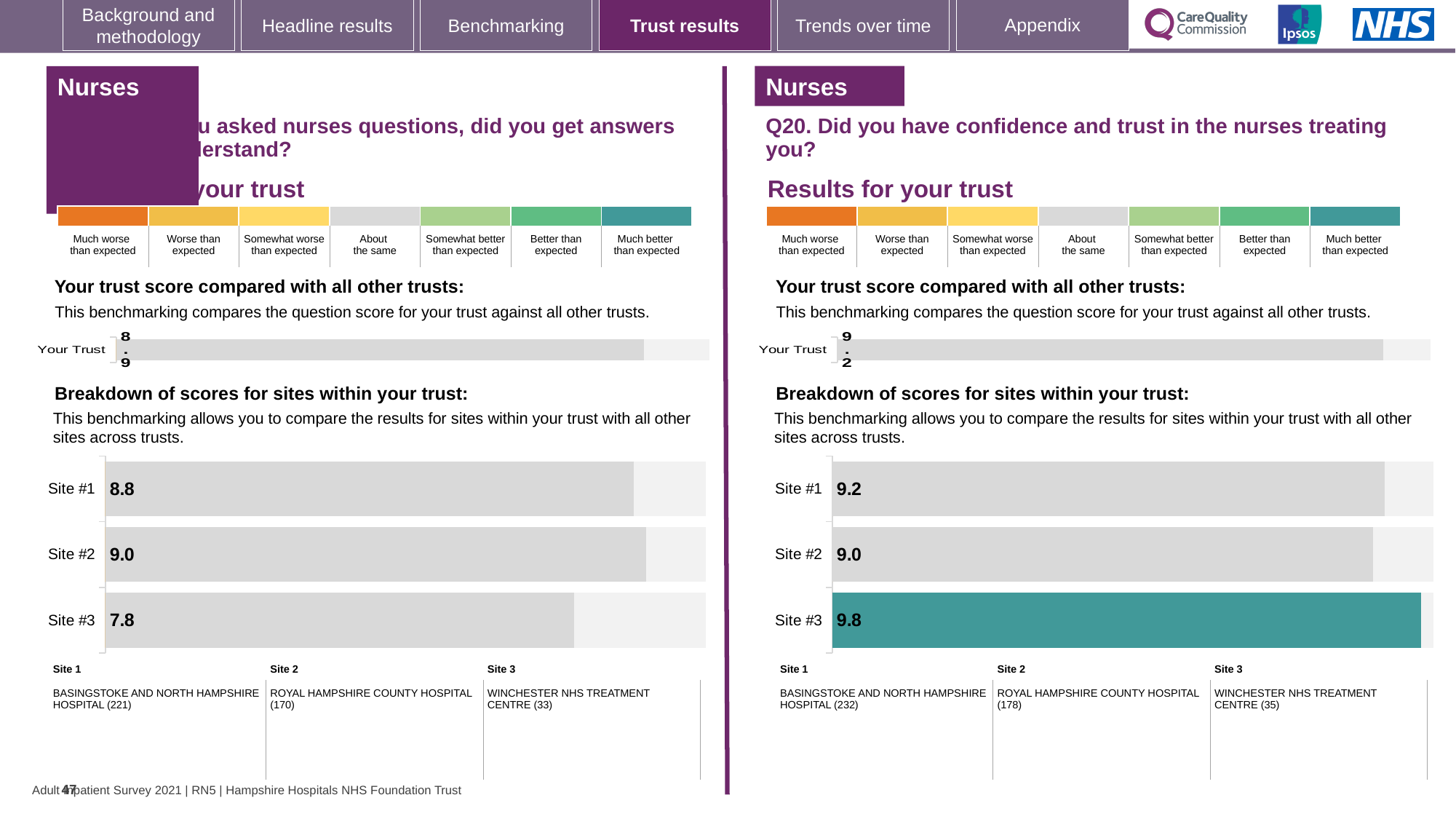
What type of chart is used for the breakdown of scores for sites within your trust in the Q20 panel? Bar chart In the Q20 panel's breakdown of scores for sites within your trust, what is the difference between the scores for Site #3 and Site #1? 0.6 How many sites are shown in the Q20 panel's breakdown of scores for sites within your trust? 3 In the left panel's breakdown of scores for sites within your trust, what is the score for Site #3? 7.8 In the left panel's 'Your trust score compared with all other trusts' chart, what is the score for Your Trust? 8.9 In the Q20 panel's breakdown of scores for sites within your trust, which site has the lowest score? Site #2 In the left panel's breakdown of scores for sites within your trust, which site has the lowest score? Site #3 In the Q20 panel's 'Your trust score compared with all other trusts' chart, what is the score for Your Trust? 9.2 In the left panel's breakdown of scores for sites within your trust, what is the difference between the scores for Site #2 and Site #3? 1.2 In the left panel's breakdown of scores for sites within your trust, which site has the highest score? Site #2 In the Q20 panel's breakdown of scores for sites within your trust, which site has the highest score? Site #3 In the Q20 panel's breakdown of scores for sites within your trust, what is the score for Site #3? 9.8